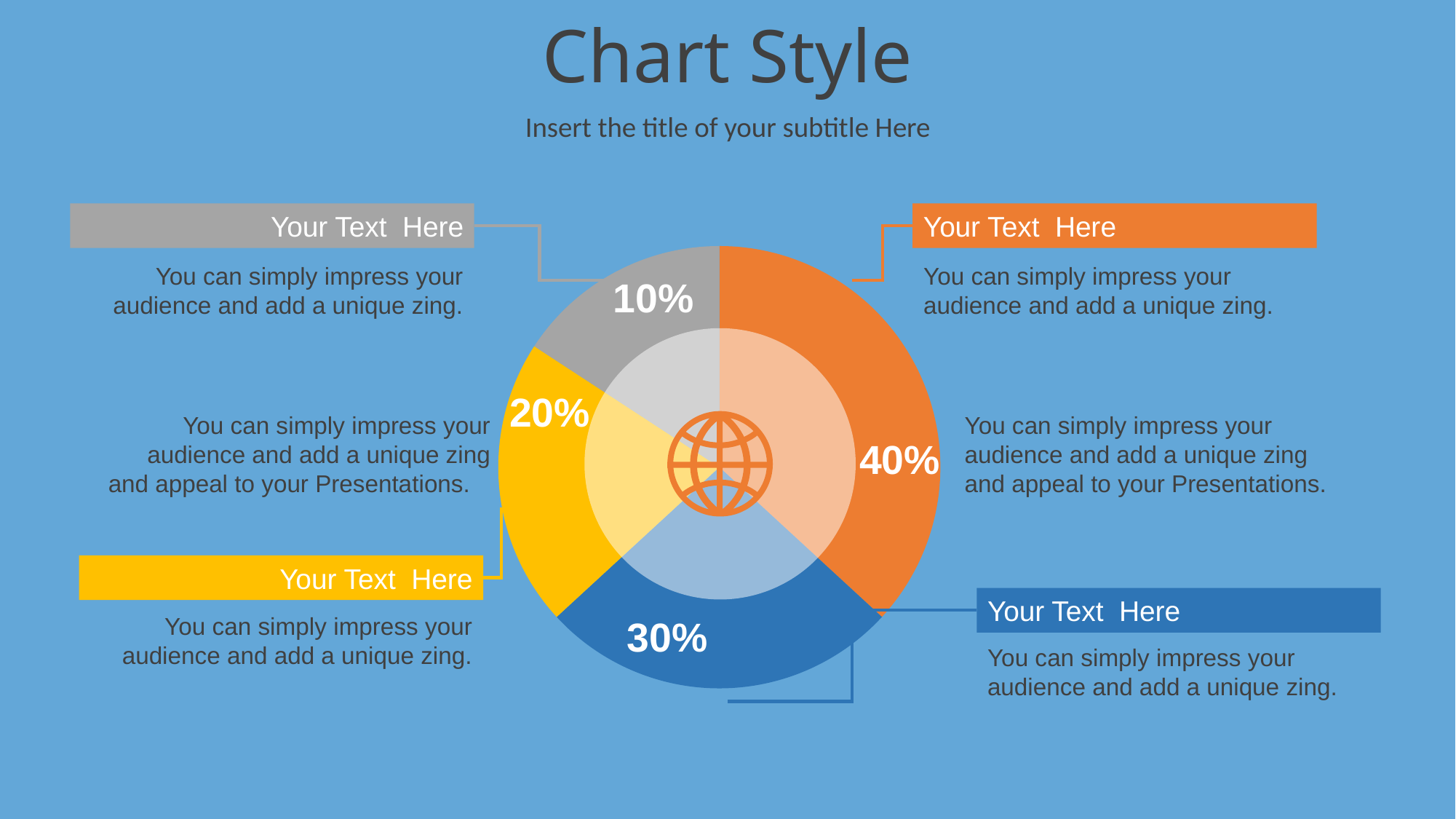
Which colour slice has the smallest share of the pie chart? gray What percentage is shown on the gray slice of the pie chart? 10% What is the combined share of the yellow and gray slices? 30% What percentage is shown on the orange slice of the pie chart? 40% What kind of chart is shown on the slide? pie chart Which colour slice has the largest share of the pie chart? orange What percentage is shown on the yellow slice of the pie chart? 20% What percentage is shown on the blue slice of the pie chart? 30% What is the difference in percentage points between the orange slice and the blue slice? 10 Which is larger, the yellow slice or the blue slice? blue slice What is the title of the slide containing the pie chart? Chart Style How many slices does the pie chart have? 4